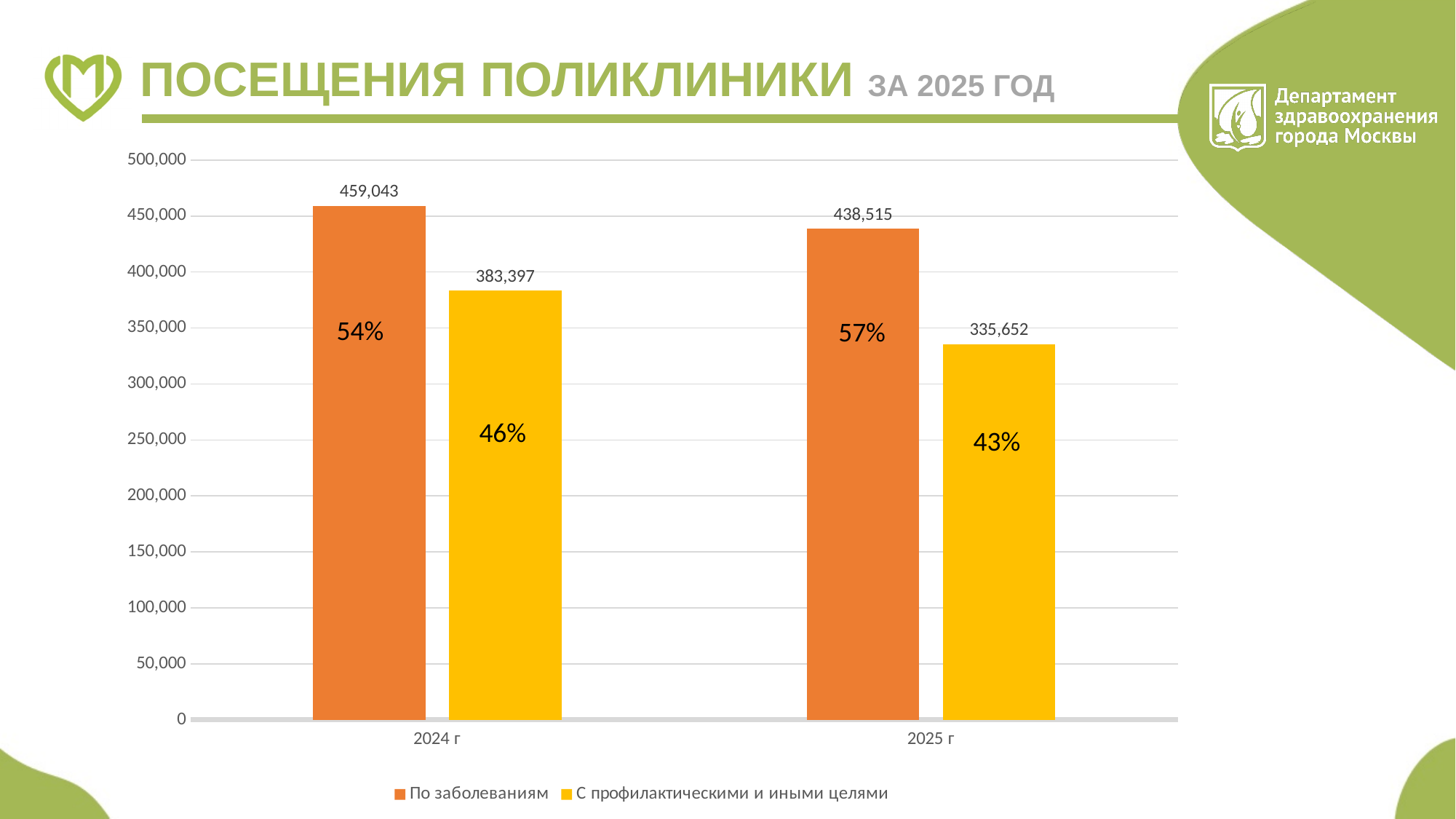
What percentage is shown on the «По заболеваниям» bar for 2025 г? 57% What is the difference between «По заболеваниям» in 2024 г and in 2025 г? 20,528 Which is larger: «С профилактическими и иными целями» in 2024 г or in 2025 г? 2024 г Which bar has the lowest value on the chart? С профилактическими и иными целями, 2025 г Do the values for «По заболеваниям» rise or fall from 2024 г to 2025 г? Fall How many series does the legend list? 2 What is the value for «С профилактическими и иными целями» in 2025 г? 335,652 How many year categories are shown on the x axis? 2 What is the value for «По заболеваниям» in 2024 г? 459,043 Which bar has the highest value on the chart? По заболеваниям, 2024 г What is the value for «С профилактическими и иными целями» in 2024 г? 383,397 What kind of chart is shown on the slide? Bar chart